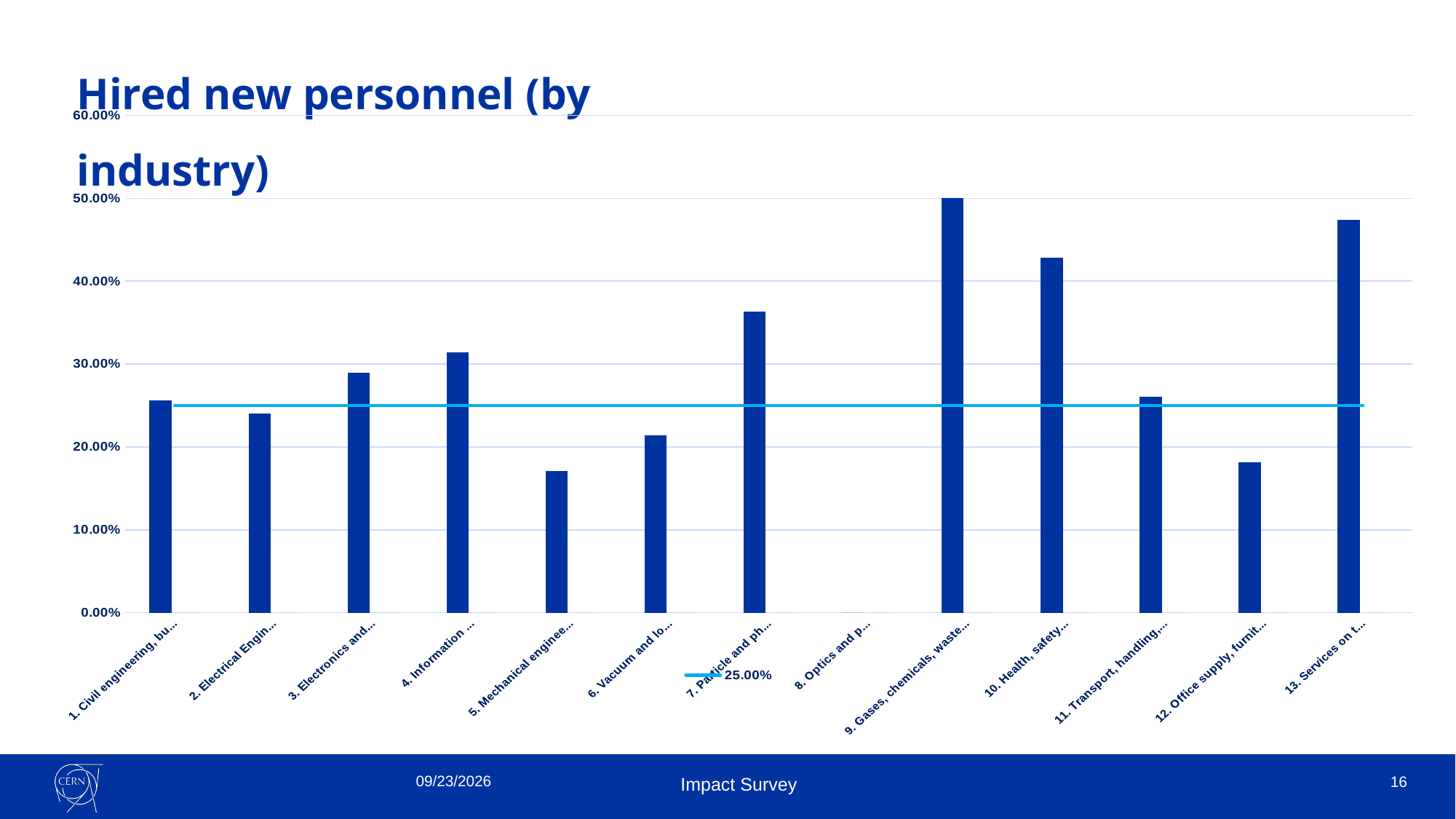
How many industry categories are shown on the x axis? 13 Is the value for '9. Gases, chemicals, waste...' greater or less than 40.00%? greater Which has the larger value: '7. Particle and ph...' or '10. Health, safety...'? 10. Health, safety... Is the value for '7. Particle and ph...' greater or less than 30.00%? greater What value does the horizontal reference line in the legend represent? 25.00% What kind of chart is shown on the slide? bar chart Which has the larger value: '9. Gases, chemicals, waste...' or '13. Services on t...'? 9. Gases, chemicals, waste... Is the value for '6. Vacuum and lo...' greater or less than 25.00%? less Which industry category has the highest bar? 9. Gases, chemicals, waste... What is the title of the chart? Hired new personnel (by industry)